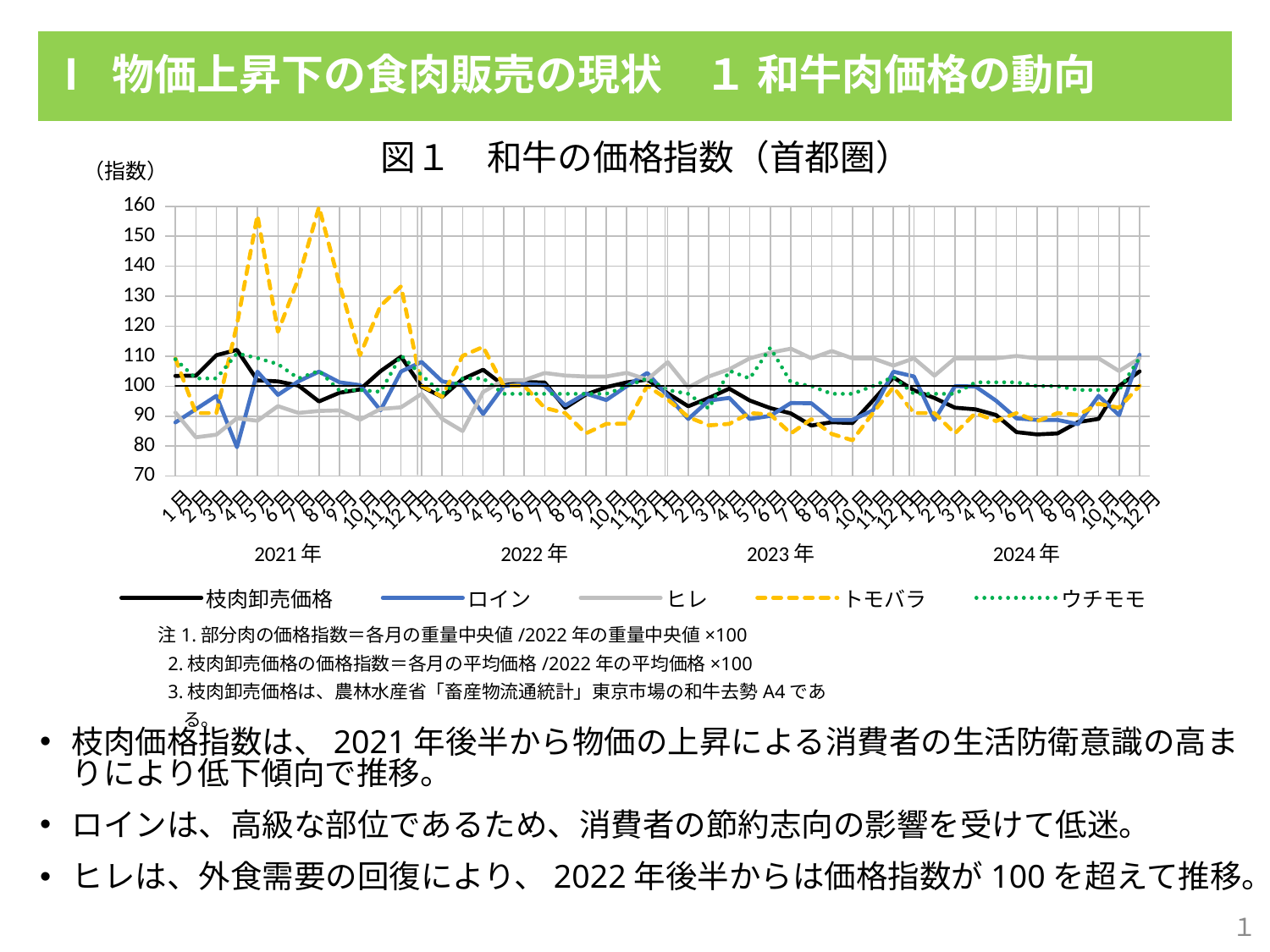
Is the value for 枝肉卸売価格 in 2024年7月 greater or less than 90? less In 2021年8月, which is larger, トモバラ or ロイン? トモバラ What is the title of the chart? 図１ 和牛の価格指数（首都圏） Which series reaches the highest value anywhere on the chart? トモバラ Which series are listed in the chart's legend? 枝肉卸売価格, ロイン, ヒレ, トモバラ, ウチモモ How many series does the legend of the chart list? 5 Does the 枝肉卸売価格 series rise or fall from 2021年12月 to 2024年7月? fall Is the value for ヒレ in 2024年7月 greater or less than 100? greater Is the value for トモバラ in 2021年8月 greater or less than 140? greater How many years does the x axis of the chart cover? 4 What kind of chart is shown in 図1 和牛の価格指数（首都圏）? line chart